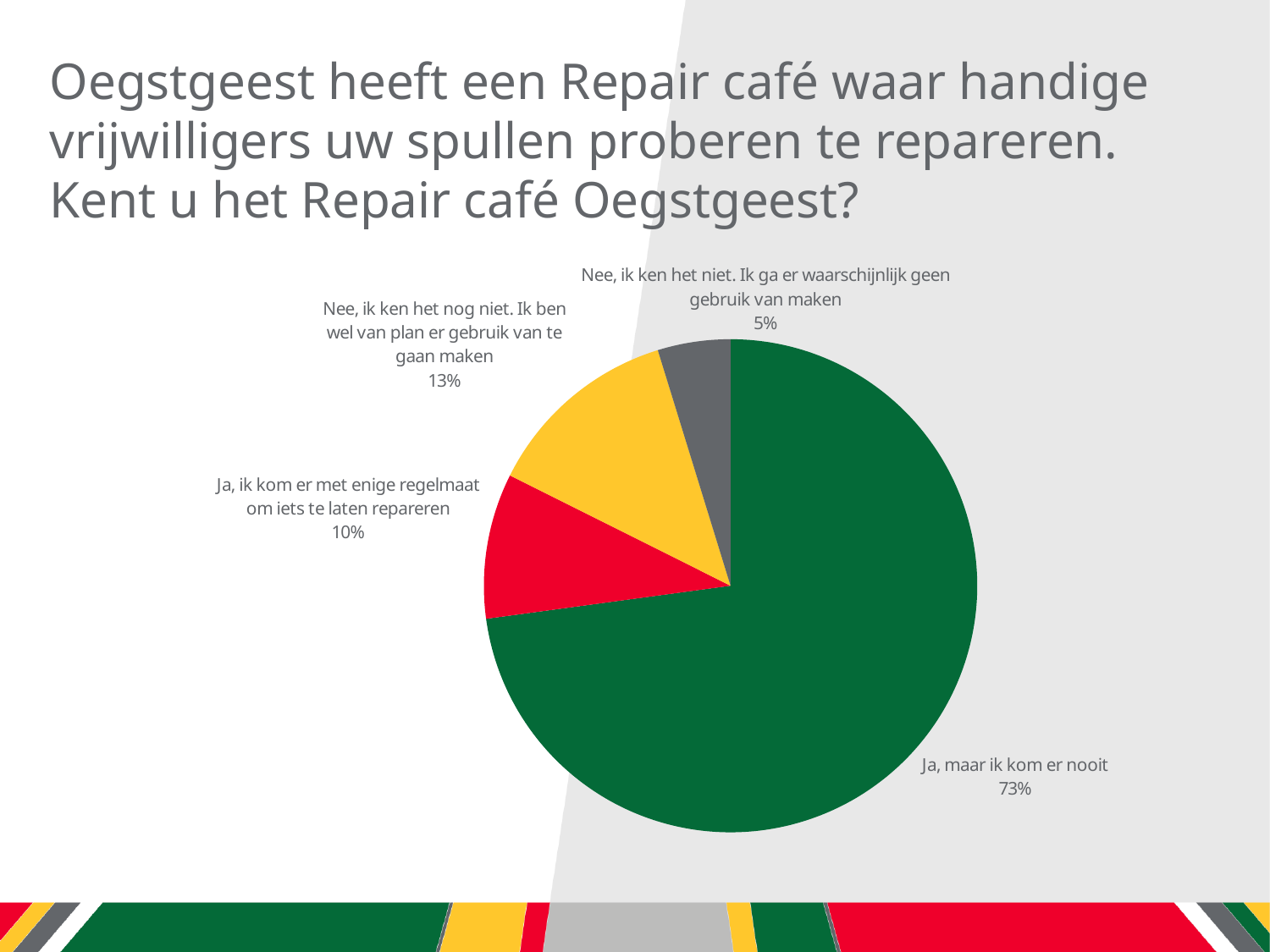
What percentage of respondents answered "Ja, ik kom er met enige regelmaat om iets te laten repareren"? 10% What percentage of respondents answered "Nee, ik ken het nog niet. Ik ben wel van plan er gebruik van te gaan maken"? 13% How many slices does the pie chart have? 4 Which answer category has the smallest share of the pie? Nee, ik ken het niet. Ik ga er waarschijnlijk geen gebruik van maken What is the combined percentage of the two "Nee" answers? 18% Which is larger: the share for "Nee, ik ken het nog niet. Ik ben wel van plan er gebruik van te gaan maken" or the share for "Ja, ik kom er met enige regelmaat om iets te laten repareren"? Nee, ik ken het nog niet. Ik ben wel van plan er gebruik van te gaan maken What is the difference in percentage points between "Ja, maar ik kom er nooit" and "Nee, ik ken het nog niet. Ik ben wel van plan er gebruik van te gaan maken"? 60 Which answer category has the largest share of the pie? Ja, maar ik kom er nooit What kind of chart is shown on the slide? pie chart What colour is the slice for "Ja, ik kom er met enige regelmaat om iets te laten repareren"? red What percentage of respondents answered "Nee, ik ken het niet. Ik ga er waarschijnlijk geen gebruik van maken"? 5% What percentage of respondents answered "Ja, maar ik kom er nooit"? 73%